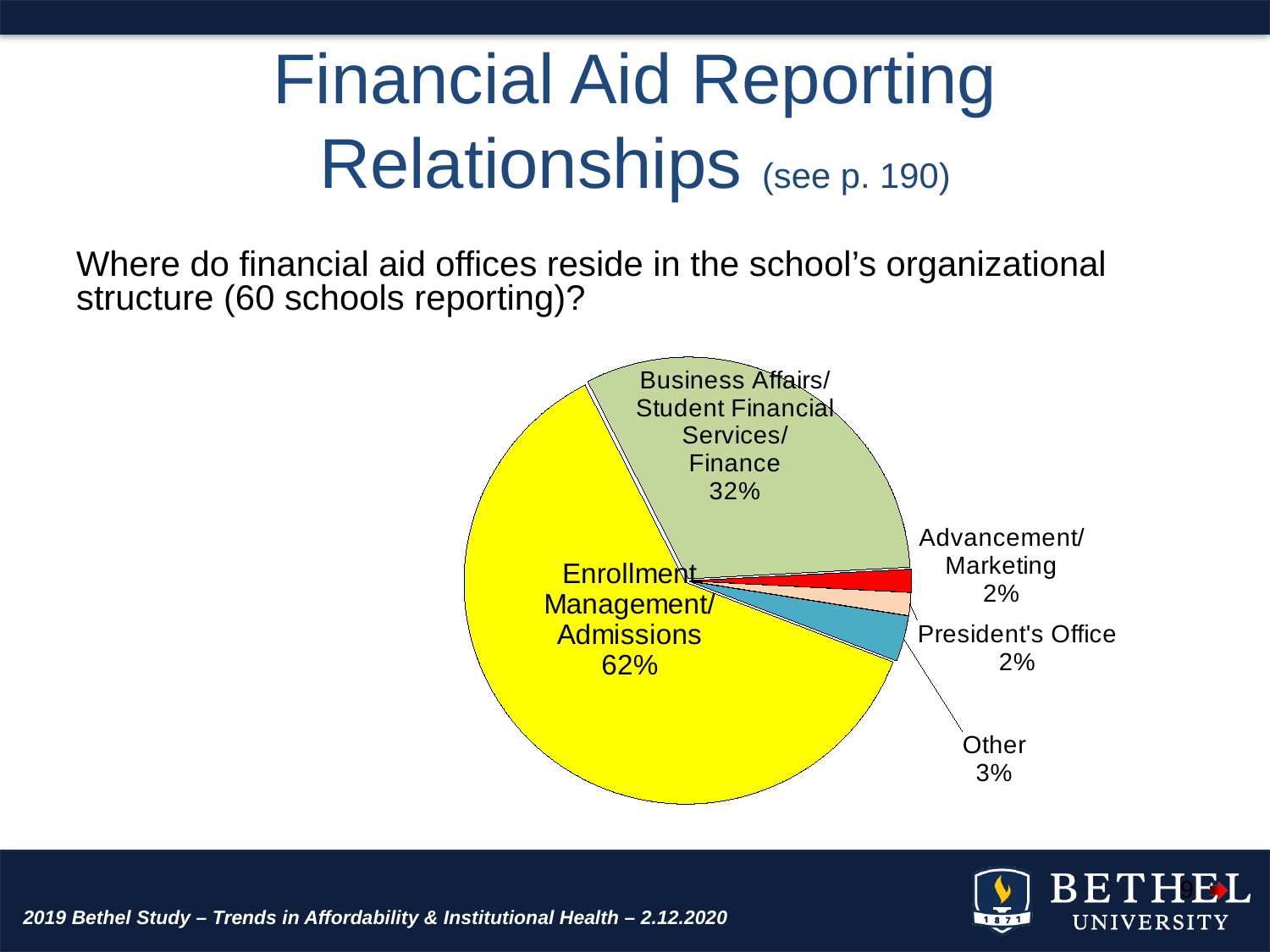
What percentage is shown for President's Office? 2% What kind of chart is shown on the slide? pie chart What colour is the Enrollment Management/Admissions slice? yellow What percentage is shown for Advancement/Marketing? 2% What is the combined percentage of Advancement/Marketing, President's Office and Other? 7% What percentage is shown for Business Affairs/Student Financial Services/Finance? 32% Which category has the largest slice of the pie? Enrollment Management/Admissions Which is larger, the Other slice or the President's Office slice? Other What share of the pie does Enrollment Management/Admissions hold? 62% What is the difference in percentage points between Enrollment Management/Admissions and Business Affairs/Student Financial Services/Finance? 30 How many slices does the pie chart have? 5 What percentage is shown for the Other slice? 3%